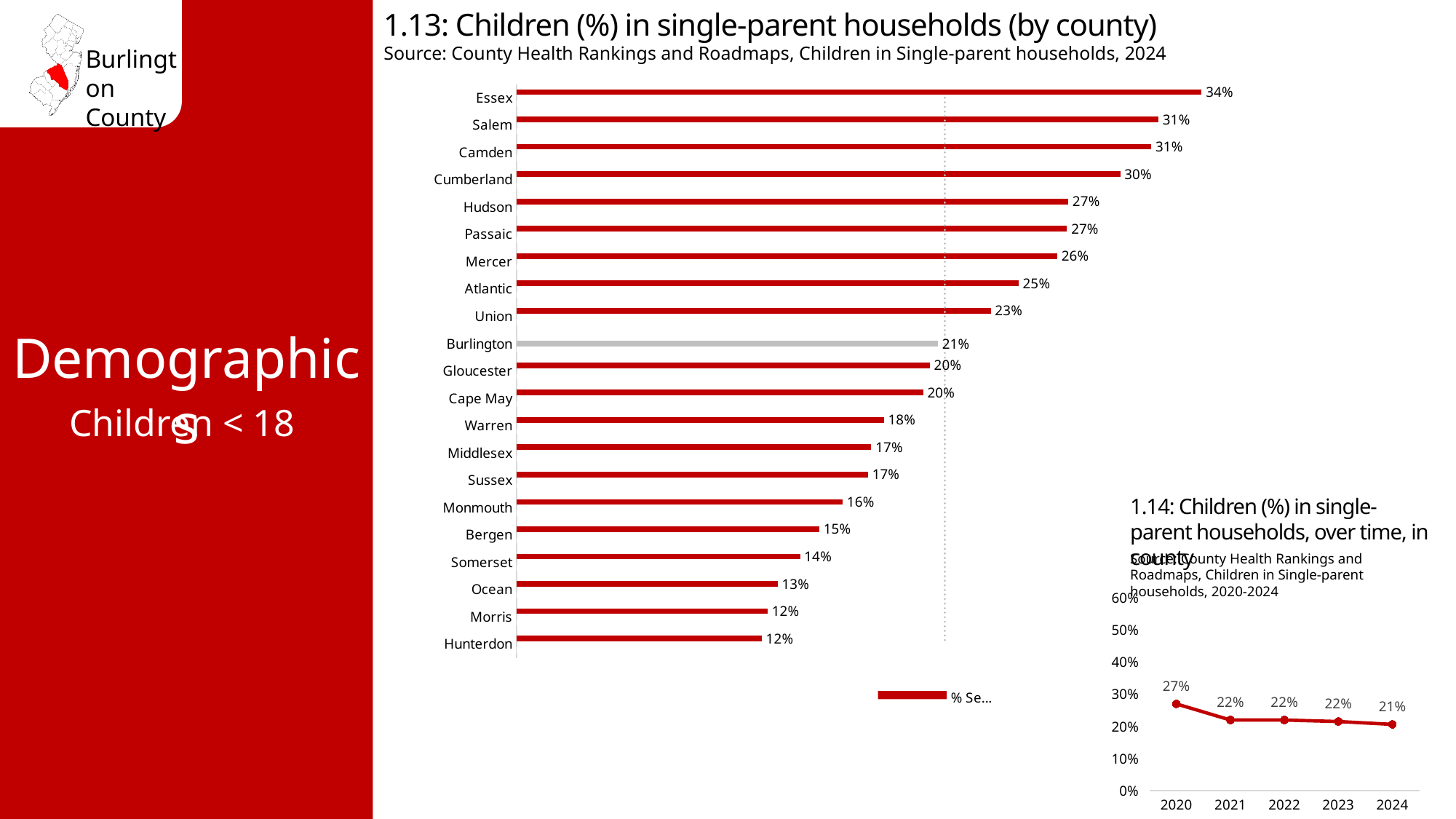
In chart 1.13 (Children in single-parent households by county), what is the value for Burlington? 21% In chart 1.14 (over time, in county), do the values rise or fall from 2020 to 2024? Fall In chart 1.13 (by county), which county has the highest percentage of children in single-parent households? Essex What kind of chart is chart 1.14 (over time, in county)? Line chart In chart 1.13 (by county), what is the difference between Essex and Burlington? 13 percentage points What kind of chart is chart 1.13 (by county)? Bar chart In chart 1.13 (by county), which is larger, the value for Hudson or the value for Atlantic? Hudson In chart 1.13 (by county), how many counties are shown? 21 In chart 1.14 (over time, in county), what is the value for 2024? 21% In chart 1.13 (by county), what is the value for Cumberland? 30% In chart 1.14 (over time, in county), what is the value for 2020? 27% In chart 1.13 (by county), what is the value for Essex? 34%